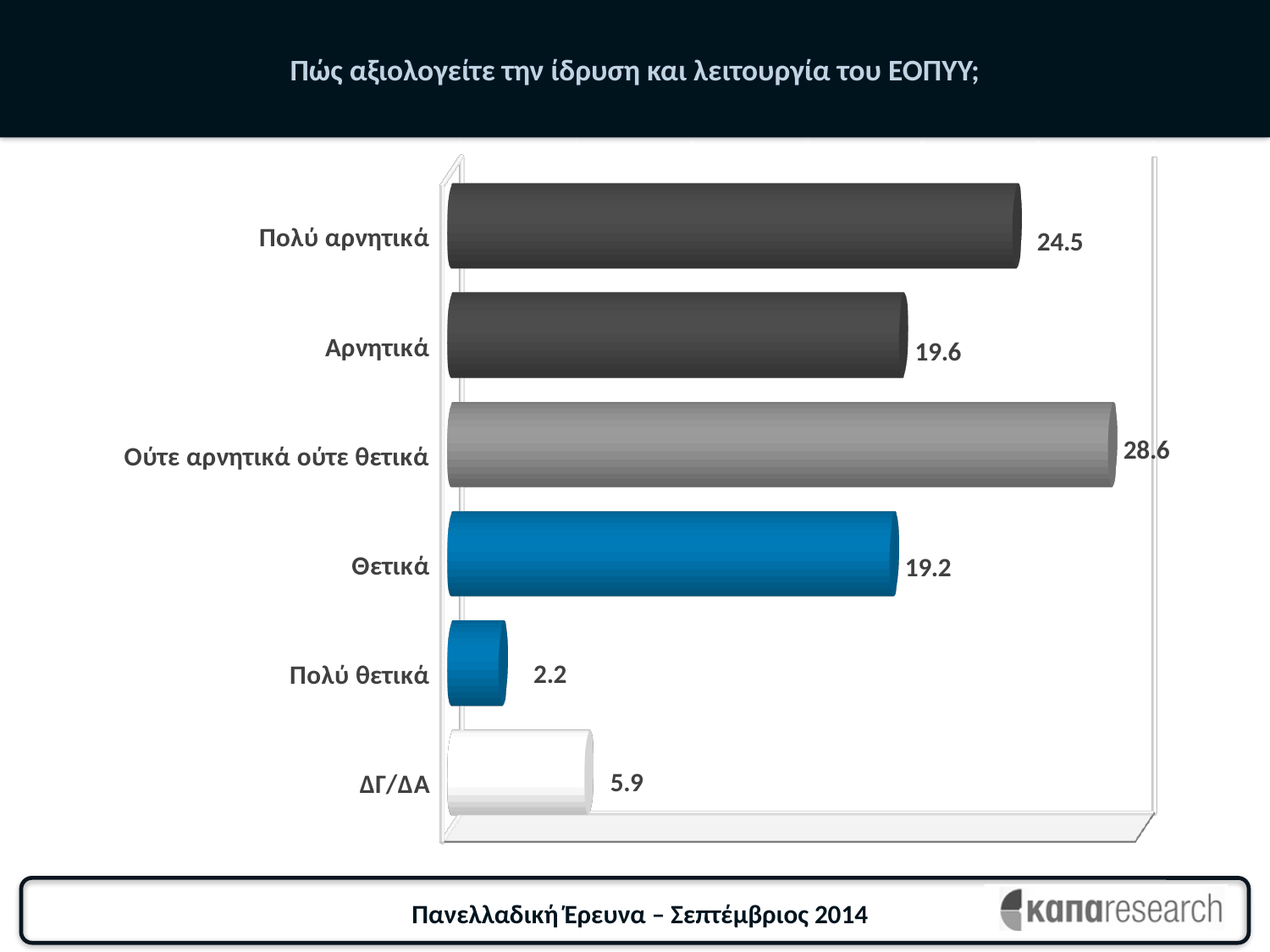
What is the difference between the values for Ούτε αρνητικά ούτε θετικά and Θετικά? 9.4 How many categories are shown in the chart? 6 Which is larger, the value for Πολύ αρνητικά or the value for Θετικά? Πολύ αρνητικά Which category has the highest value? Ούτε αρνητικά ούτε θετικά What kind of chart is shown on the slide? Bar chart Which category has the lowest value? Πολύ θετικά What is the value for Πολύ θετικά? 2.2 What is the value for ΔΓ/ΔΑ? 5.9 What is the value for Ούτε αρνητικά ούτε θετικά? 28.6 What is the value for Πολύ αρνητικά? 24.5 What is the difference between the values for Πολύ αρνητικά and Αρνητικά? 4.9 What is the title of the chart? Πώς αξιολογείτε την ίδρυση και λειτουργία του ΕΟΠΥΥ;